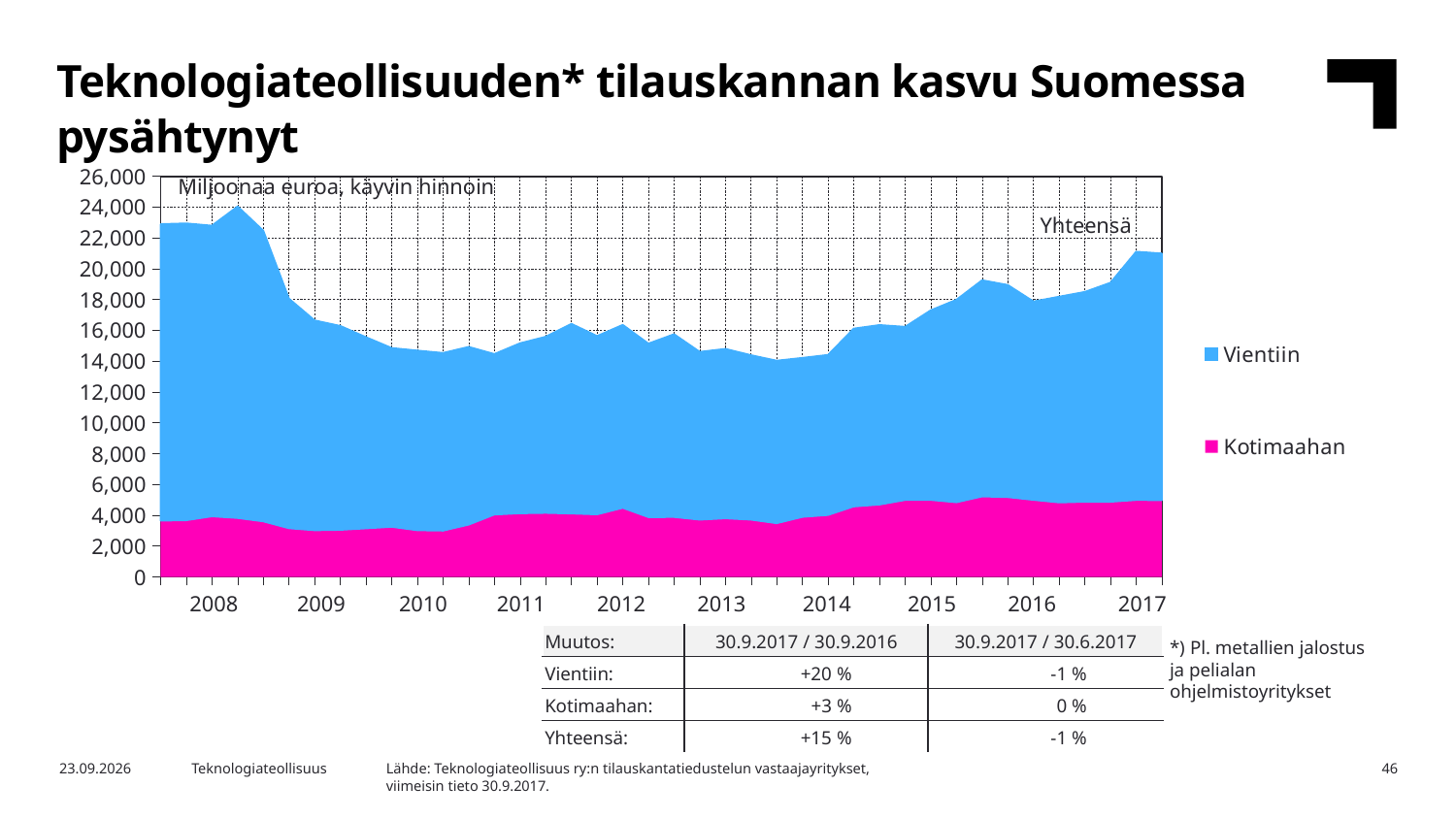
How many series does the chart legend list? 2 Is the Kotimaahan value in 2010 greater or less than 4,000? less Does the total (Yhteensä) value rise or fall from 2008 to 2010? fall What unit label is shown inside the chart area? Miljoonaa euroa, käyvin hinnoin Does the total (Yhteensä) value rise or fall from 2014 to 2017? rise Which is larger, the total (Yhteensä) value in 2008 or in 2014? 2008 Is the total (Yhteensä) value at the start of 2008 greater or less than 20,000? greater Is the Kotimaahan value in 2017 greater or less than 4,000? greater How many year labels are shown on the x axis? 10 What kind of chart is shown on the slide? Stacked area chart Which two series are listed in the chart legend? Vientiin and Kotimaahan